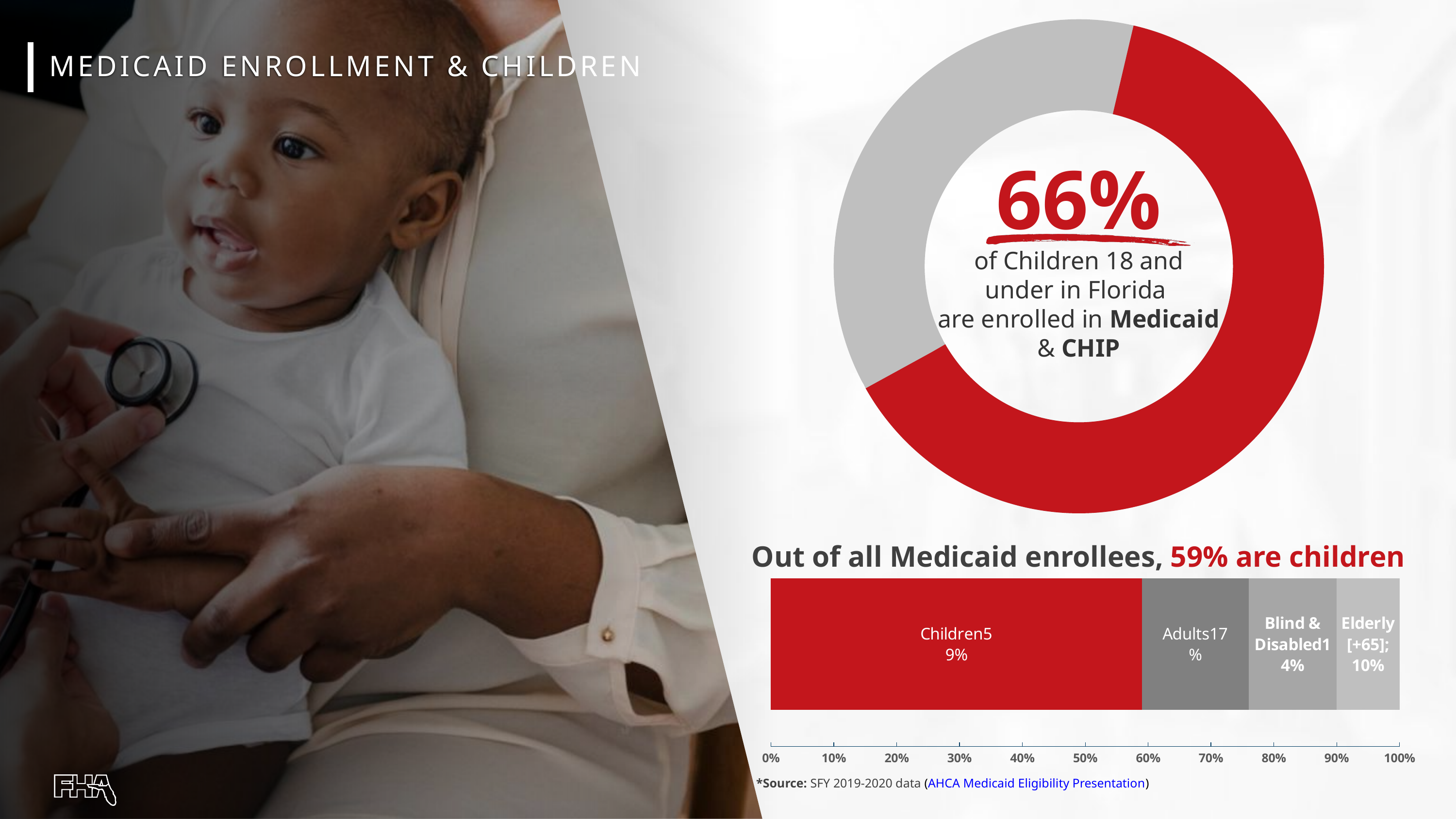
In the 'Out of all Medicaid enrollees' chart, which group has the smallest share of enrollees? Elderly [+65] In the donut chart, what percentage of children 18 and under in Florida are enrolled in Medicaid & CHIP? 66% In the 'Out of all Medicaid enrollees' chart, how many groups make up the stacked bar? 4 In the 'Out of all Medicaid enrollees' chart, what share of Medicaid enrollees are children? 59% In the 'Out of all Medicaid enrollees' chart, what share of Medicaid enrollees are Blind & Disabled? 14% In the 'Out of all Medicaid enrollees' chart, how many percentage points larger is the Children share than the Adults share? 42% In the donut chart, what colour is the slice representing children enrolled in Medicaid & CHIP? Red What kind of chart is the 'Out of all Medicaid enrollees' chart? Stacked bar chart In the 'Out of all Medicaid enrollees' chart, which group has the largest share of enrollees? Children What kind of chart is the chart at the top right of the slide? Donut (pie) chart In the 'Out of all Medicaid enrollees' chart, what share of Medicaid enrollees are adults? 17% In the 'Out of all Medicaid enrollees' chart, what share of Medicaid enrollees are Elderly [+65]? 10%